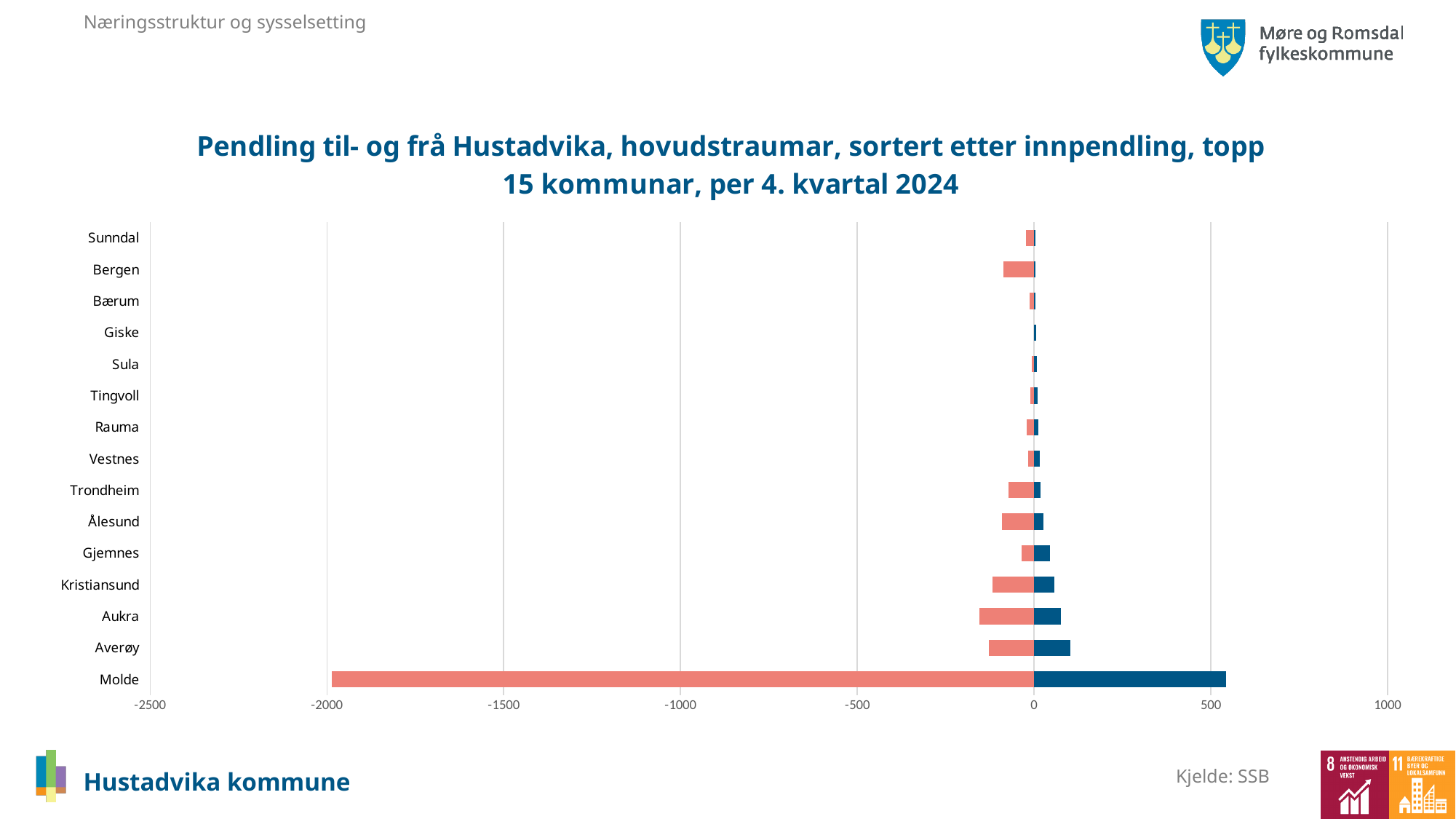
Which municipality has the longest blue (positive) bar in the chart? Molde What kind of chart is shown on the slide? Bar chart Is the value of the blue bar for Averøy greater or less than 500? less Which municipality has the longest red (negative) bar in the chart? Molde Is the value of the red bar for Kristiansund greater or less than -500? greater Is the value of the red bar for Molde greater or less than -1500? less Which has the longer blue bar, Molde or Averøy? Molde What source is cited for the chart data on the slide? SSB Which municipality is listed at the bottom of the vertical axis? Molde How many municipalities (categories) are listed on the vertical axis of the chart? 15 Which has the longer red bar, Aukra or Bergen? Aukra